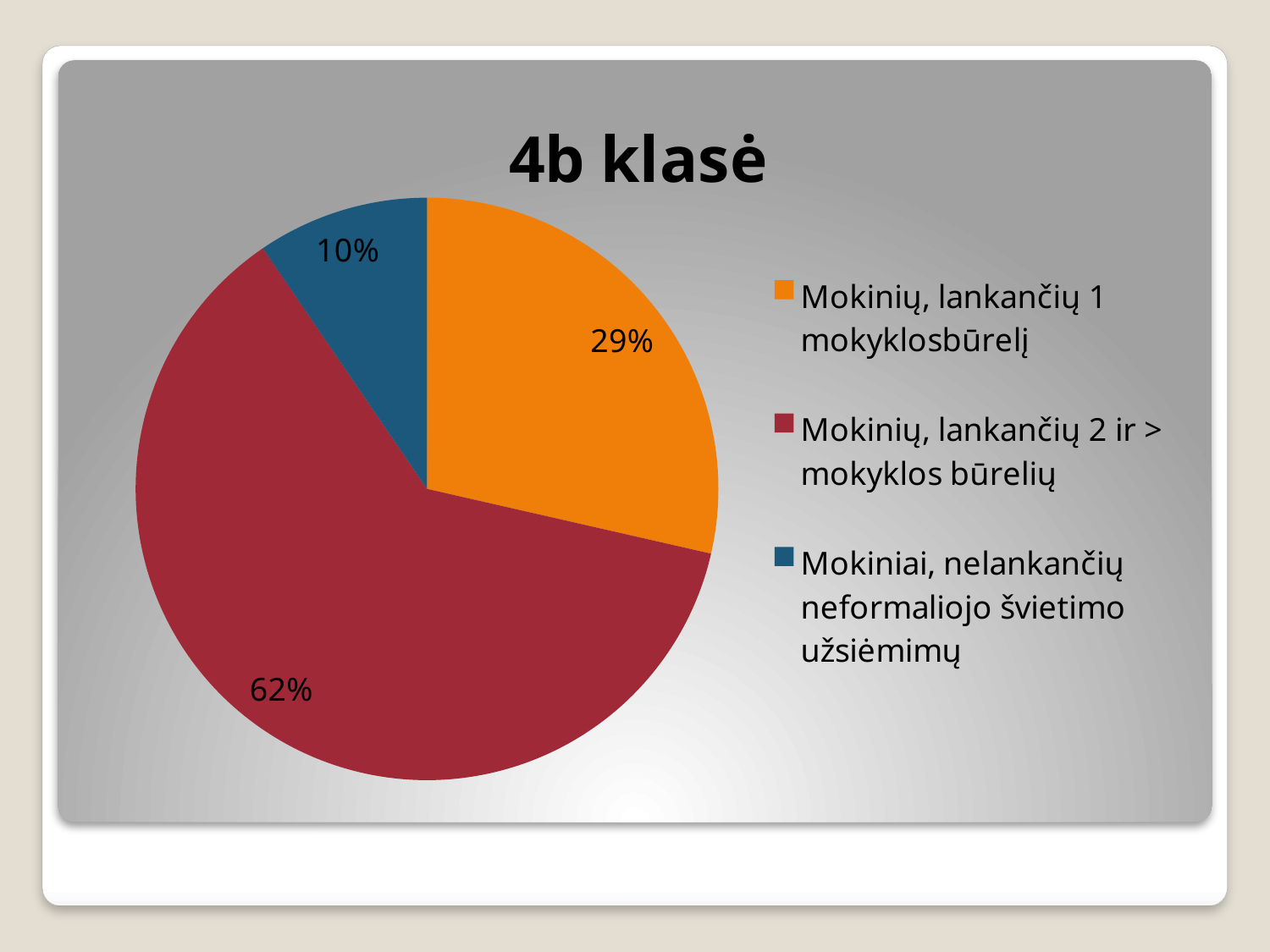
What is the title of the chart? 4b klasė What share of the pie is labelled for "Mokinių, lankančių 1 mokyklosbūrelį"? 29% Which category has the smallest slice of the pie? Mokiniai, nelankančių neformaliojo švietimo užsiėmimų Which category has the largest slice of the pie? Mokinių, lankančių 2 ir > mokyklos būrelių What share of the pie is labelled for "Mokiniai, nelankančių neformaliojo švietimo užsiėmimų"? 10% What kind of chart is shown on the slide? pie chart How many entries does the legend list? 3 What is the difference in percentage points between the slice for "Mokinių, lankančių 2 ir > mokyklos būrelių" and the slice for "Mokinių, lankančių 1 mokyklosbūrelį"? 33 percentage points How many slices does the pie chart have? 3 Which is larger: the slice for "Mokinių, lankančių 1 mokyklosbūrelį" or the slice for "Mokiniai, nelankančių neformaliojo švietimo užsiėmimų"? Mokinių, lankančių 1 mokyklosbūrelį What colour is the slice for "Mokiniai, nelankančių neformaliojo švietimo užsiėmimų"? blue What share of the pie is labelled for "Mokinių, lankančių 2 ir > mokyklos būrelių"? 62%